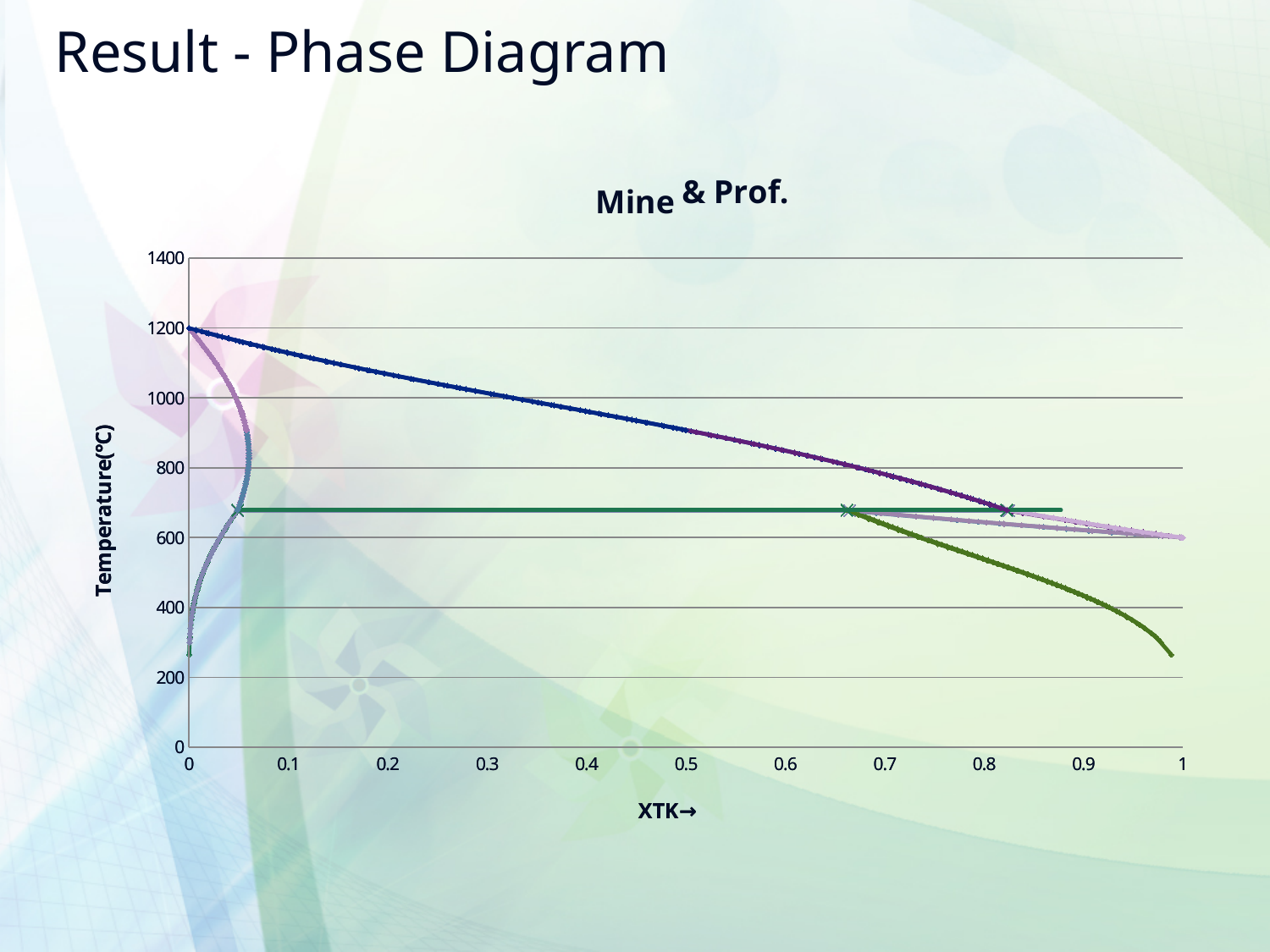
What temperature does the upper (liquidus) curve start at when XTK is 0? 1200 What is the title of the chart? Mine & Prof. Is the temperature of the horizontal green line greater or less than 800? less Is the temperature of the horizontal green line greater or less than 600? greater What is the maximum value shown on the temperature axis? 1400 Is the temperature of the upper curve at XTK = 0.5 greater or less than 800? greater What kind of chart is shown on the slide? line chart What is the label of the vertical axis? Temperature(°C) Does the upper curve rise or fall as XTK increases from 0 to 1? fall